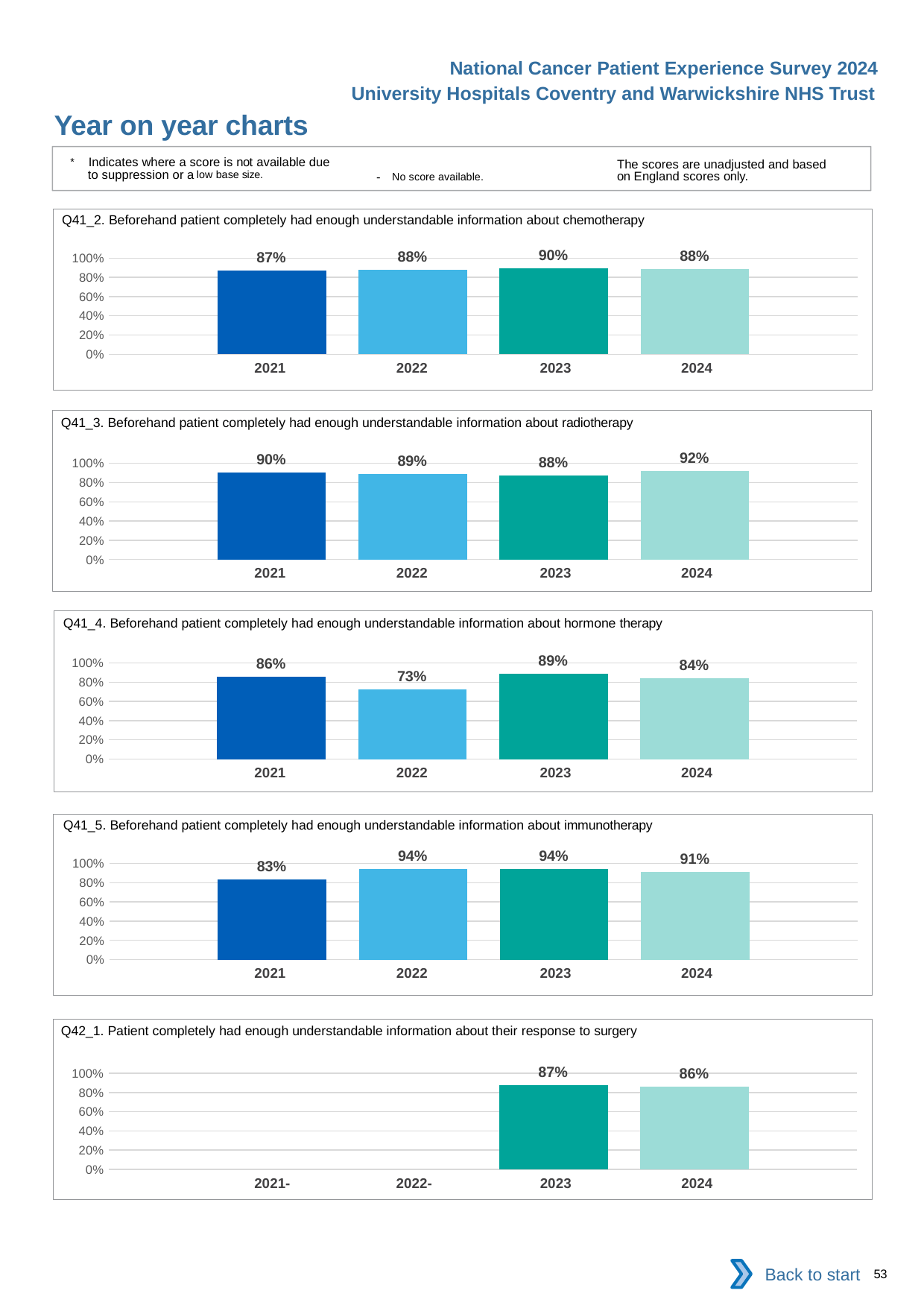
In the Q41_5 chart (immunotherapy), what is the value for 2021? 83% How many charts are shown on the slide? 5 In the Q41_3 chart (radiotherapy), which year has the highest value? 2024 In the Q41_2 chart (chemotherapy), what is the difference between the 2023 and 2021 values? 3% In the Q41_4 chart (hormone therapy), what is the difference between the 2023 and 2022 values? 16% In the Q41_5 chart (immunotherapy), is the value for 2024 larger or smaller than the value for 2021? larger In the Q42_1 chart (response to surgery), how many years have a bar plotted? 2 In the Q42_1 chart (response to surgery), what is the value for 2024? 86% What kind of chart is the Q41_2 chart (chemotherapy)? bar chart In the Q41_3 chart (radiotherapy), is the value for 2021 greater or less than 80%? greater In the Q41_4 chart (hormone therapy), which year has the lowest value? 2022 In the Q41_2 chart (chemotherapy), what is the value for 2023? 90%